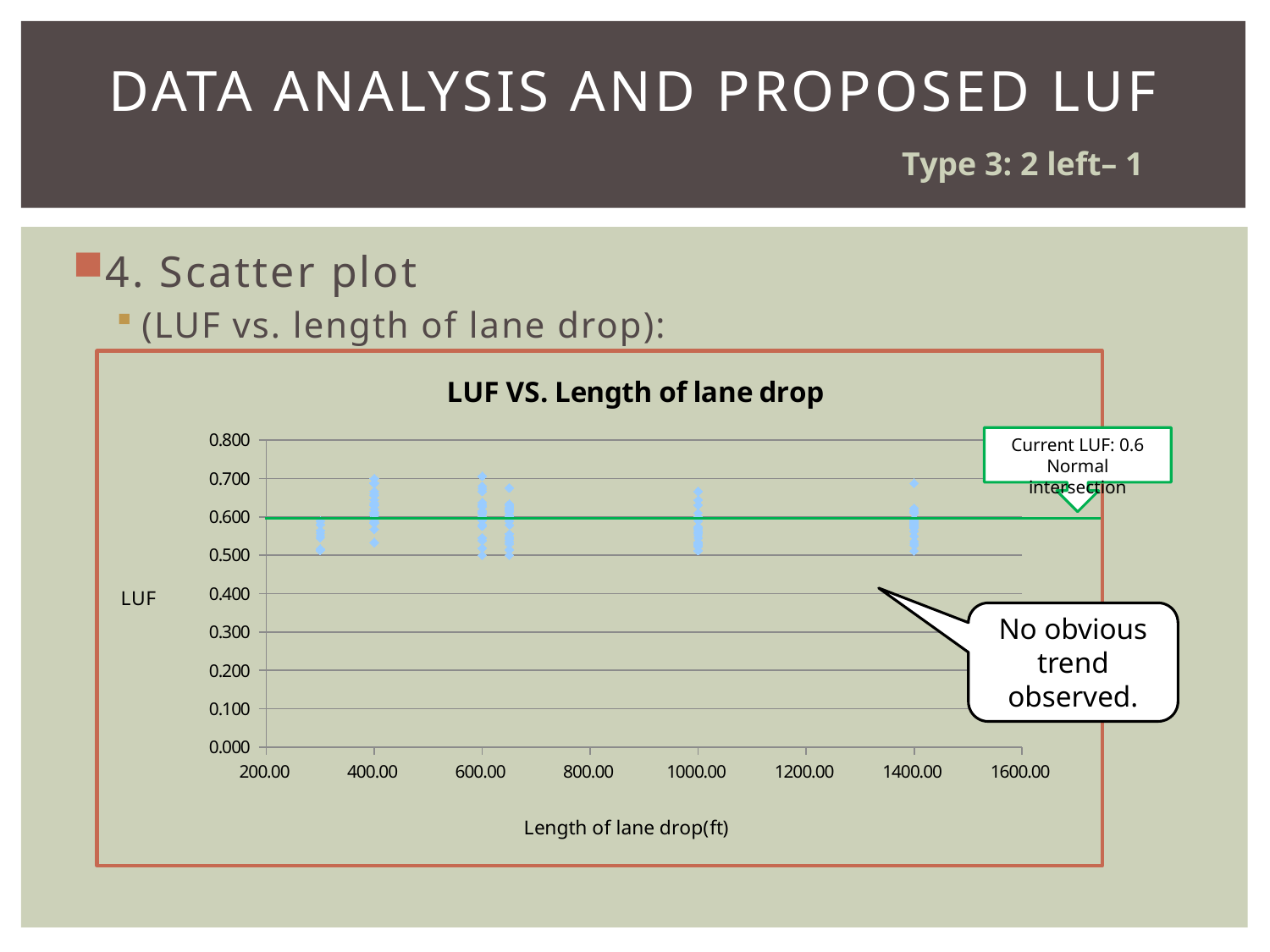
Is the highest LUF value plotted at a lane drop length of 400.00 ft greater or less than 0.600? greater What is the label of the x axis of the chart? Length of lane drop(ft) What is the title of the chart? LUF VS. Length of lane drop What kind of chart is shown on the slide? Scatter plot According to the callout on the chart, what trend is observed in LUF as the length of lane drop increases? No obvious trend observed. Is the highest plotted LUF value on the chart greater or less than 0.800? less Is the lowest plotted LUF value on the chart greater or less than 0.400? greater What is the maximum value shown on the y axis of the chart? 0.800 What value does the horizontal green line on the chart mark as the current LUF? 0.6 How many distinct lane drop lengths (vertical clusters of points) are plotted on the chart? 6